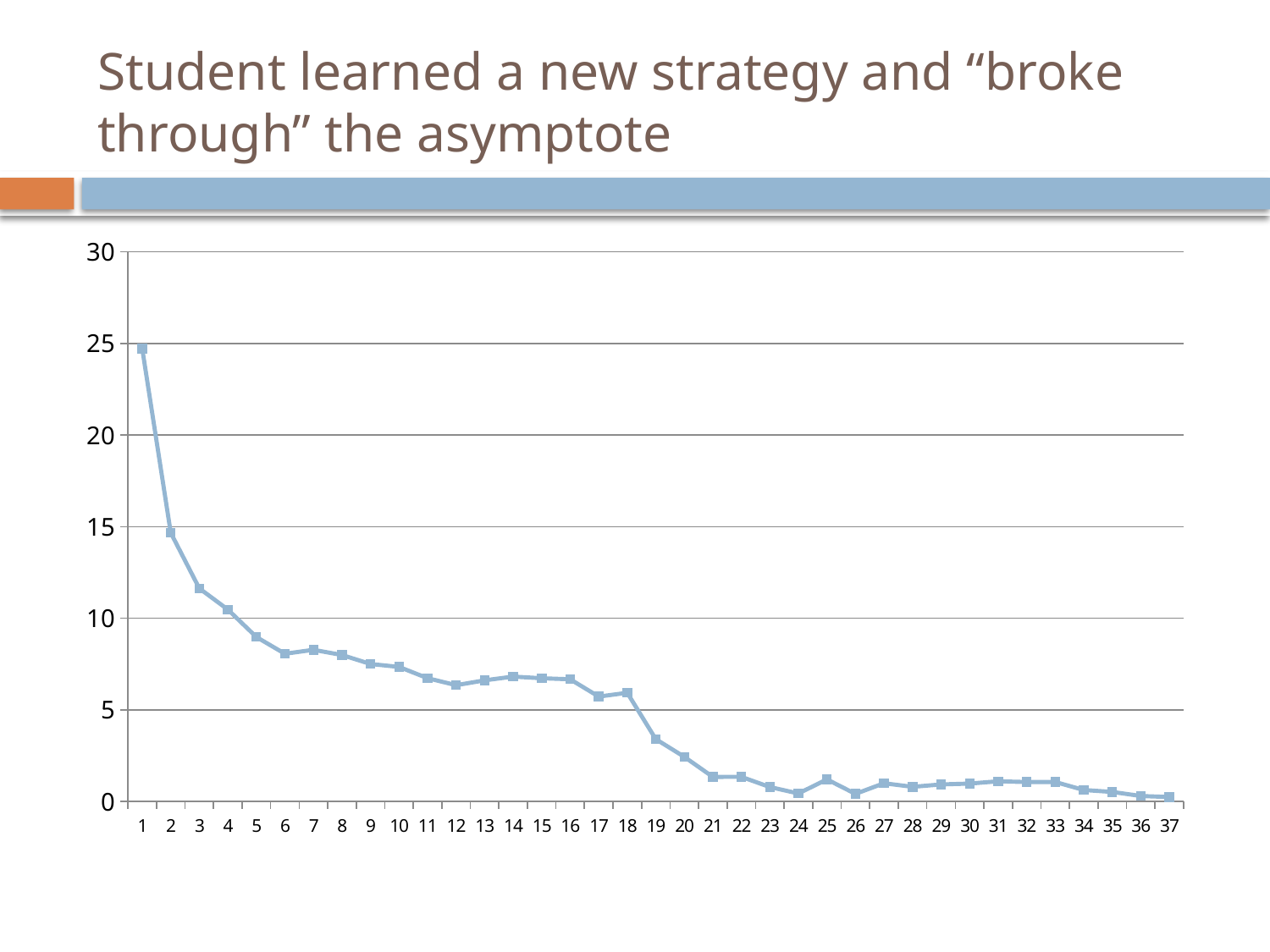
Is the value at point 1 greater or less than 20? greater Is the value at point 10 greater or less than 10? less What kind of chart is shown on the slide? line chart Which has the larger value, point 3 or point 10? 3 Do the values generally rise or fall along the x axis? fall Is the value at point 2 greater or less than 10? greater What is the title of the slide containing the chart? Student learned a new strategy and "broke through" the asymptote How many points are plotted along the x axis? 37 Which x-axis point has the highest value? 1 Which has the larger value, point 18 or point 19? 18